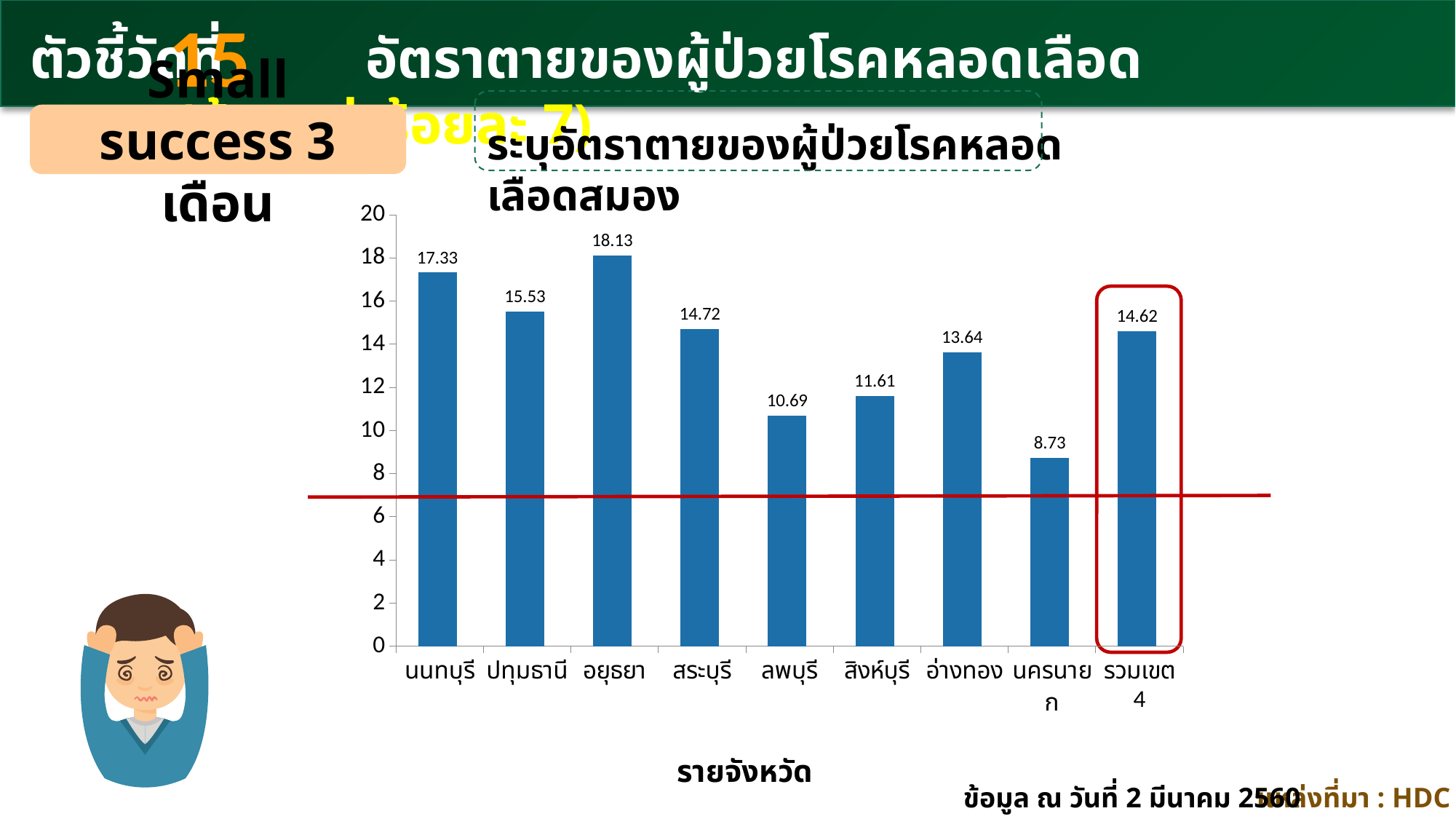
What is the x-axis label of the chart? รายจังหวัด What is the difference between the values for อยุธยา and นครนายก? 9.40 Is the value for ลพบุรี greater or less than 12? less Which is larger, the value for ปทุมธานี or the value for สระบุรี? ปทุมธานี Which category is outlined with a red box on the chart? รวมเขต 4 What is the value for นครนายก? 8.73 Which category has the lowest value? นครนายก Which province has the highest value? อยุธยา What is the value for นนทบุรี? 17.33 What kind of chart is shown on the slide? bar chart How many categories are shown on the x axis? 9 What is the value for รวมเขต 4? 14.62